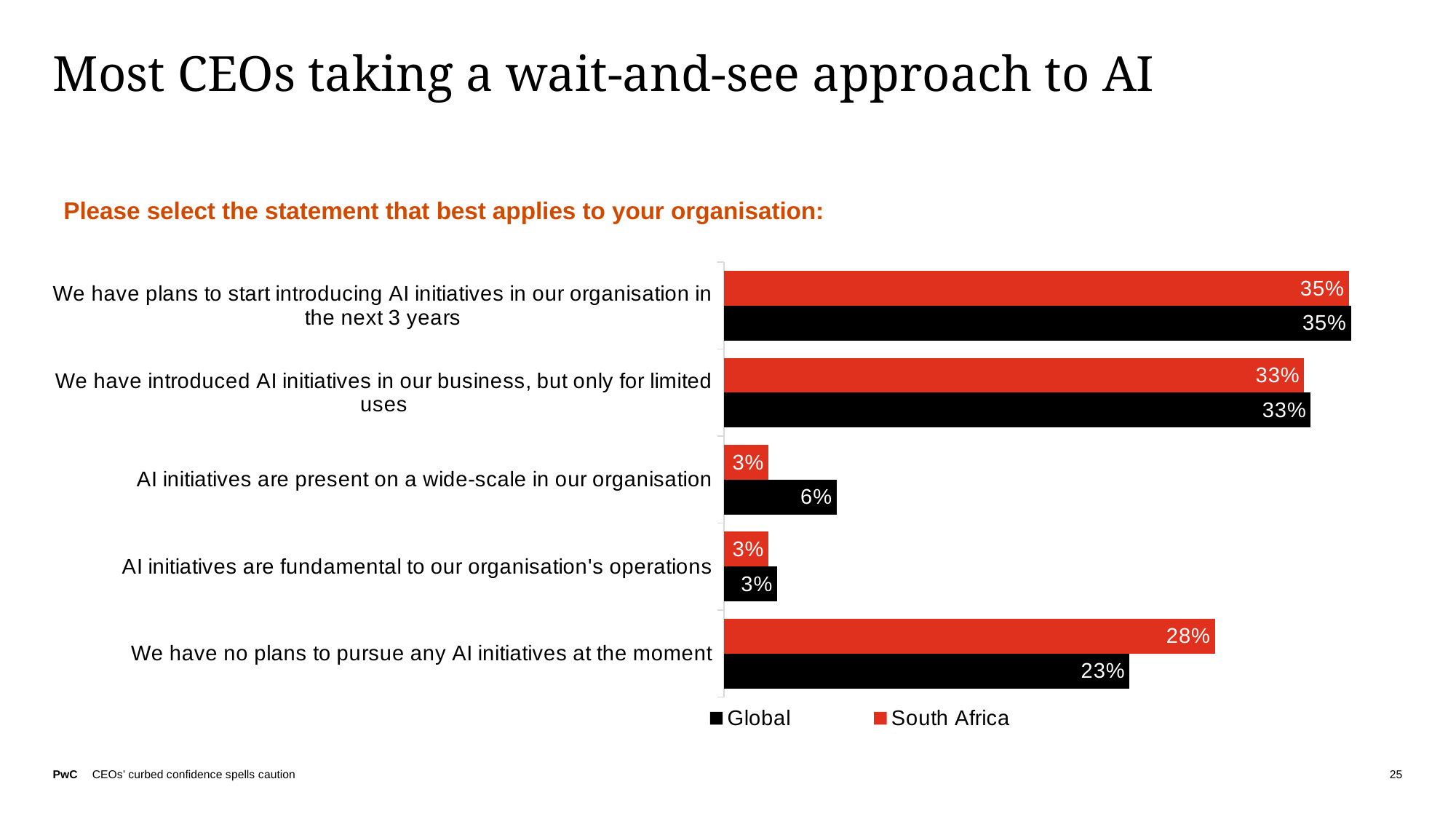
How many statements (categories) are shown in the chart? 5 What is the Global value for 'AI initiatives are present on a wide-scale in our organisation'? 6% Which statement has the highest Global value? We have plans to start introducing AI initiatives in our organisation in the next 3 years What is the Global value for 'We have no plans to pursue any AI initiatives at the moment'? 23% How many series does the legend list? 2 What is the difference between the South Africa and Global values for 'We have no plans to pursue any AI initiatives at the moment'? 5% For 'AI initiatives are present on a wide-scale in our organisation', which is larger: the Global value or the South Africa value? Global Which statement has the lowest Global value? AI initiatives are fundamental to our organisation's operations Which colour represents the South Africa series in the chart? Red What is the South Africa value for 'We have plans to start introducing AI initiatives in our organisation in the next 3 years'? 35% What type of chart is shown on the slide? Bar chart What is the South Africa value for 'We have no plans to pursue any AI initiatives at the moment'? 28%